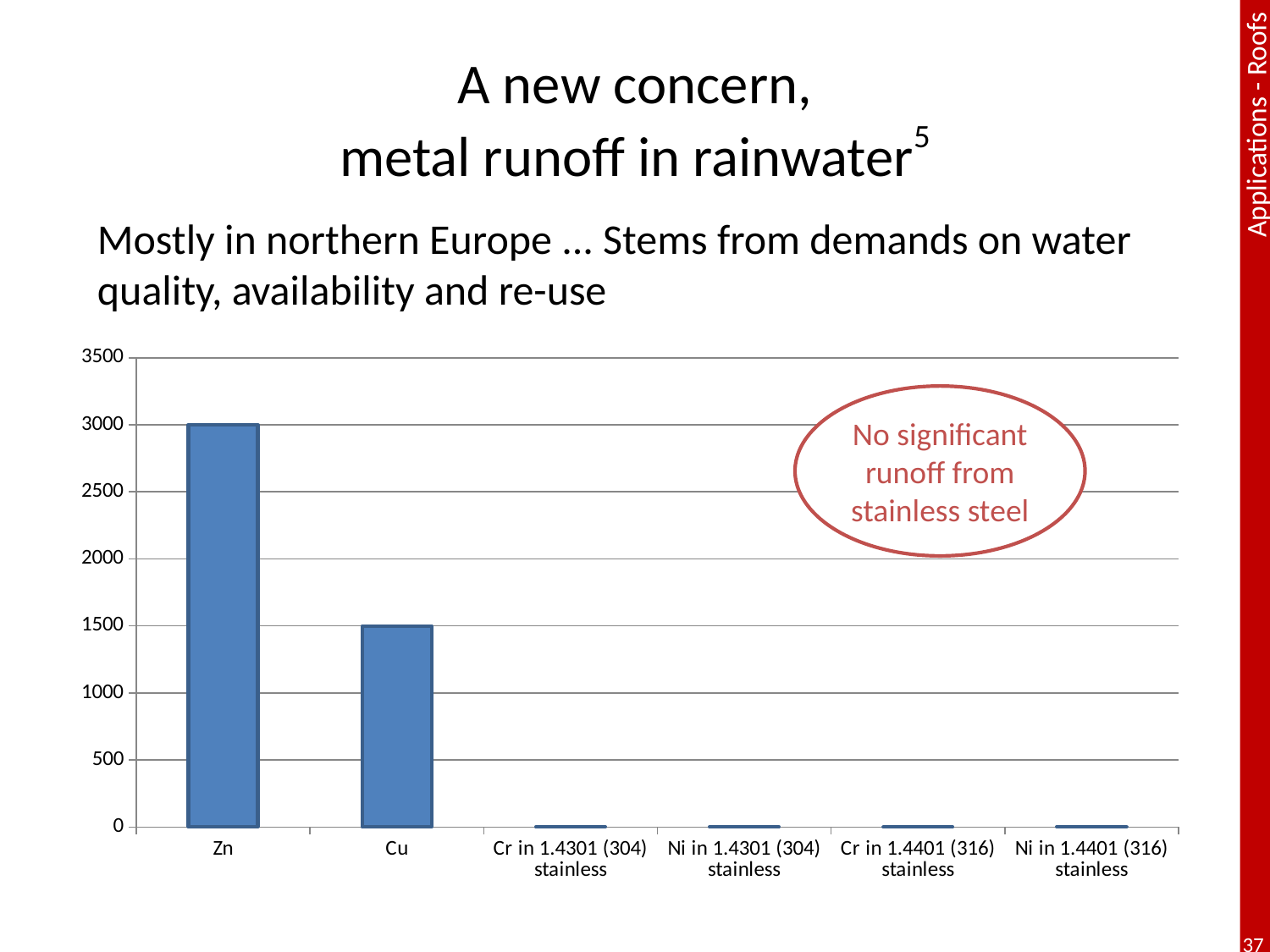
Which category has the highest bar in the chart? Zn Which is larger, the value for Cu or the value for Ni in 1.4401 (316) stainless? Cu What type of chart is shown on the slide? bar chart What is the value for Zn in the chart? 3000 What is the difference between the values for Zn and Cu? 1500 What is the value for Cu in the chart? 1500 How many categories are shown on the x axis of the chart? 6 Is the value for Cr in 1.4301 (304) stainless greater or less than 500? less What does the circled annotation on the chart say? No significant runoff from stainless steel Is the value for Zn greater or less than 2500? greater Is the value for Cu greater or less than 2000? less Which is larger, the value for Zn or the value for Cu? Zn